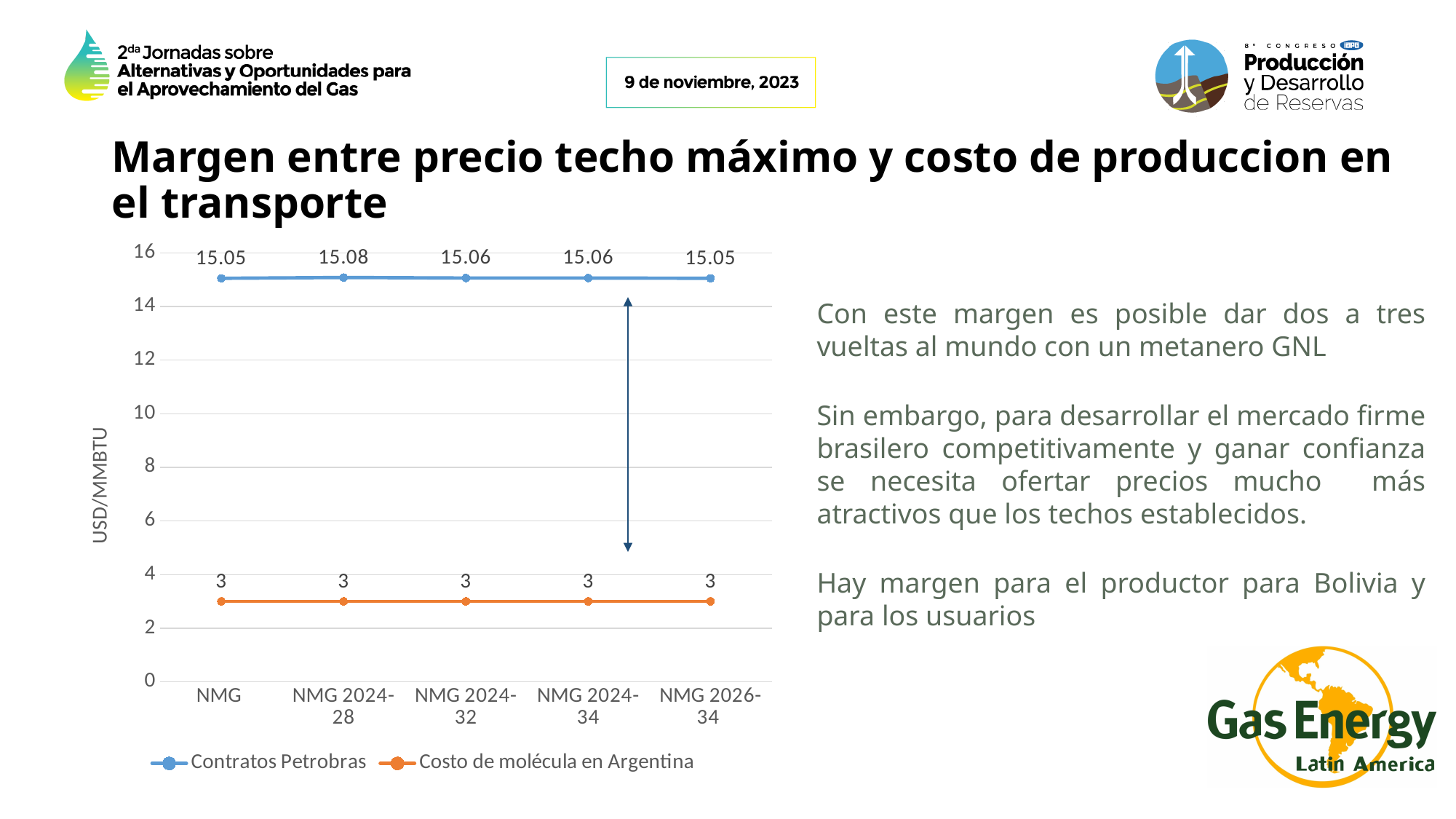
What kind of chart is shown on the slide? Line chart Does the Costo de molécula en Argentina series rise, fall or stay flat across the categories? Stays flat What is the value of Contratos Petrobras for NMG 2026-34? 15.05 How many categories are shown on the x axis? 5 Which category has the highest value for Contratos Petrobras? NMG 2024-28 What is the label of the y axis? USD/MMBTU What is the value of Contratos Petrobras for NMG 2024-28? 15.08 What is the value of Costo de molécula en Argentina for NMG 2024-32? 3 What is the difference between Contratos Petrobras and Costo de molécula en Argentina for NMG? 12.05 Is the value of Contratos Petrobras for NMG 2024-32 greater or less than 14? greater Which series has the larger value for NMG 2024-34, Contratos Petrobras or Costo de molécula en Argentina? Contratos Petrobras How many series does the legend list? 2